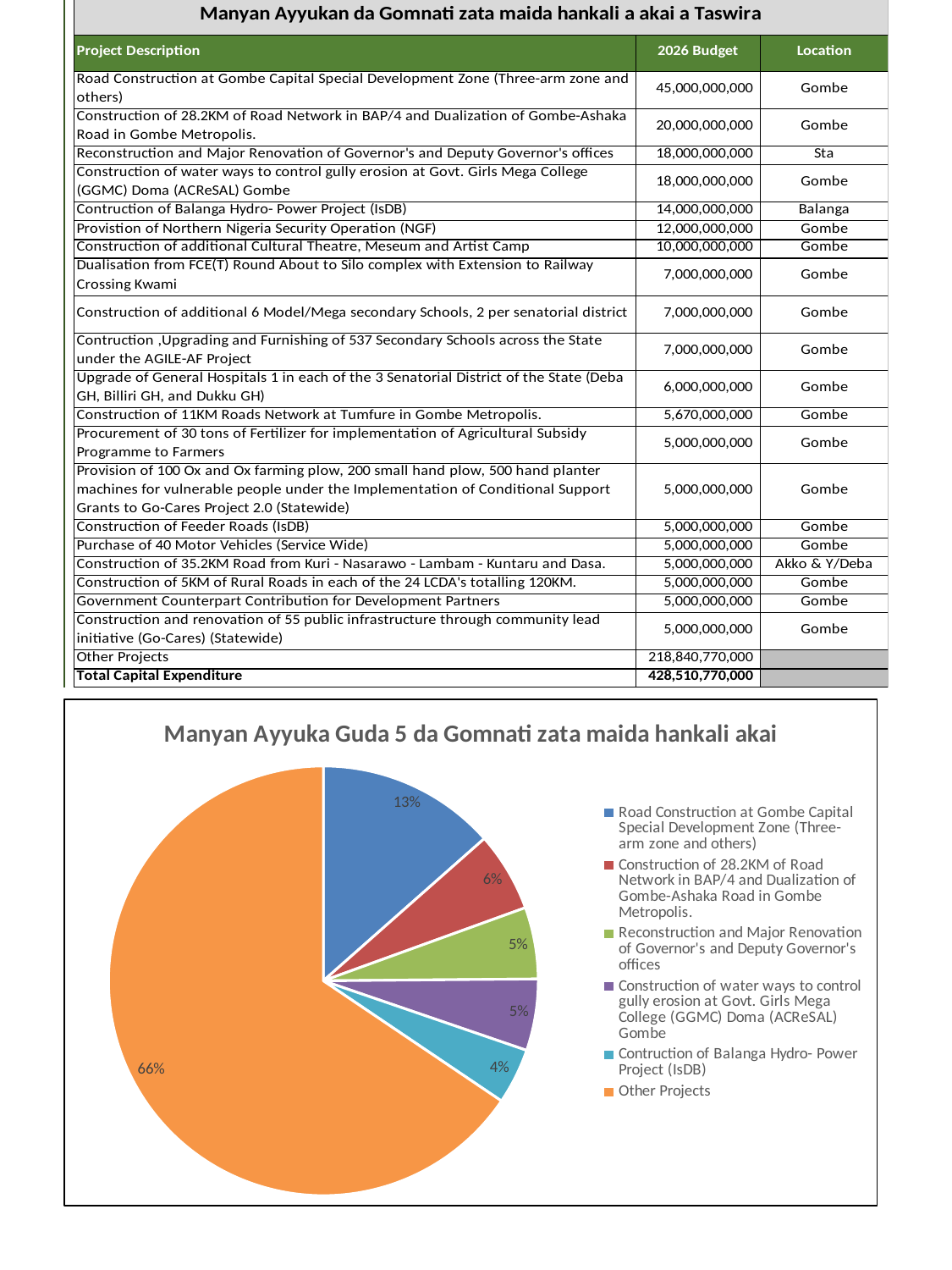
Which slice of the pie chart is the smallest? Contruction of Balanga Hydro- Power Project (IsDB) What colour is the Other Projects slice in the pie chart? orange What kind of chart is shown on the slide? pie chart Which is larger in the pie chart: Road Construction at Gombe Capital Special Development Zone or Construction of 28.2KM of Road Network in BAP/4? Road Construction at Gombe Capital Special Development Zone What is the difference in percentage points between the Other Projects slice and the Road Construction at Gombe Capital Special Development Zone slice? 53 What share of the pie chart is Construction of 28.2KM of Road Network in BAP/4 and Dualization of Gombe-Ashaka Road in Gombe Metropolis? 6% What share of the pie chart is Other Projects? 66% Which slice of the pie chart is the largest? Other Projects What share of the pie chart is Road Construction at Gombe Capital Special Development Zone (Three-arm zone and others)? 13% What is the title of the pie chart? Manyan Ayyuka Guda 5 da Gomnati zata maida hankali akai How many slices does the pie chart have? 6